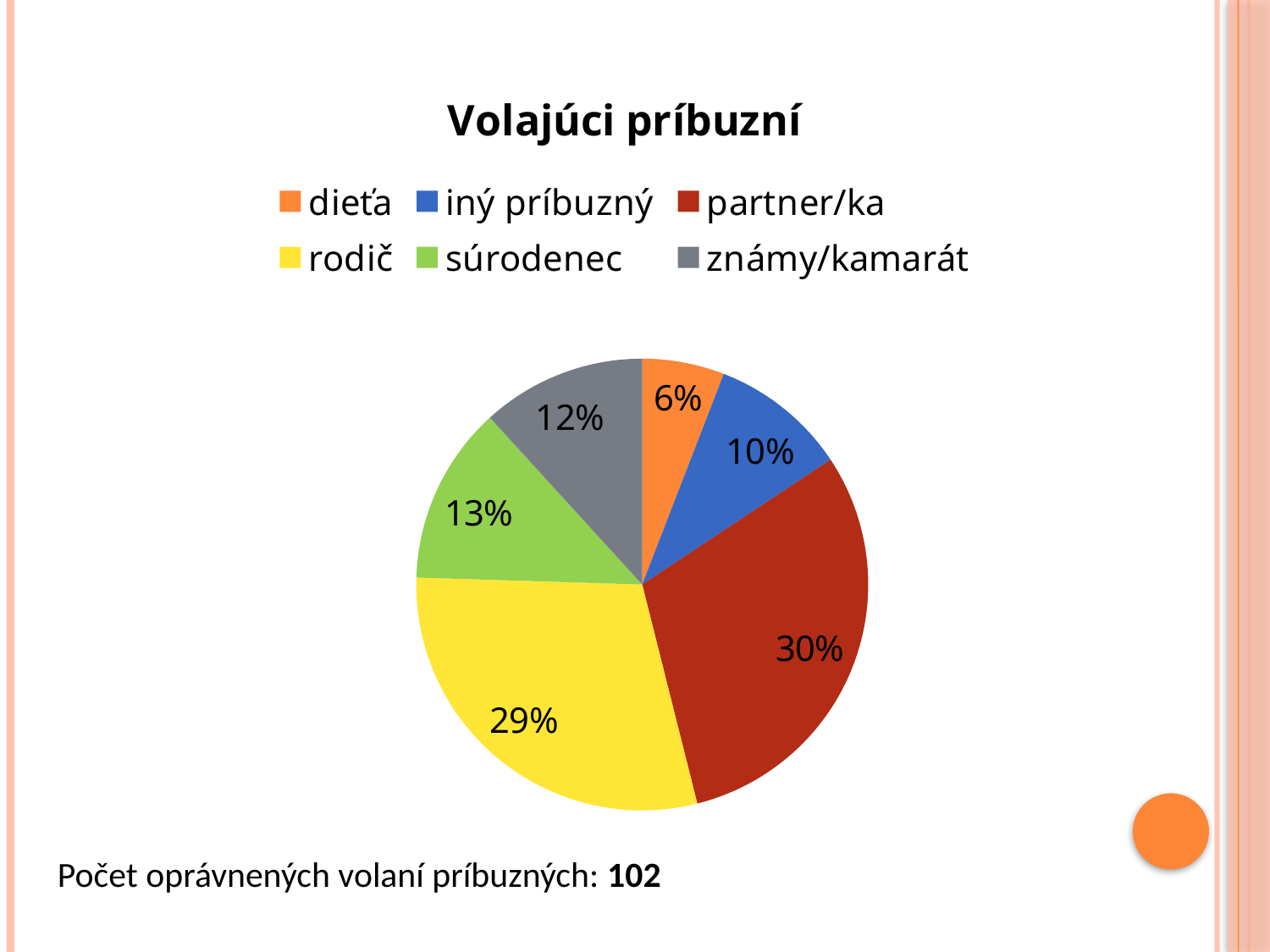
How many categories are shown in the pie chart? 6 What is the value shown for 'súrodenec'? 13% What is the title of the chart? Volajúci príbuzní Which category has the largest slice of the pie? partner/ka What is the difference in percentage points between 'súrodenec' and 'známy/kamarát'? 1 Which is larger, the slice for 'iný príbuzný' or the slice for 'známy/kamarát'? známy/kamarát What share does 'rodič' have in the pie chart? 29% What percentage is labelled on the 'dieťa' slice? 6% What type of chart is shown on the slide? pie chart What is the difference in percentage points between 'partner/ka' and 'rodič'? 1 Which category has the smallest slice of the pie? dieťa What percentage of the pie chart is the 'partner/ka' slice? 30%